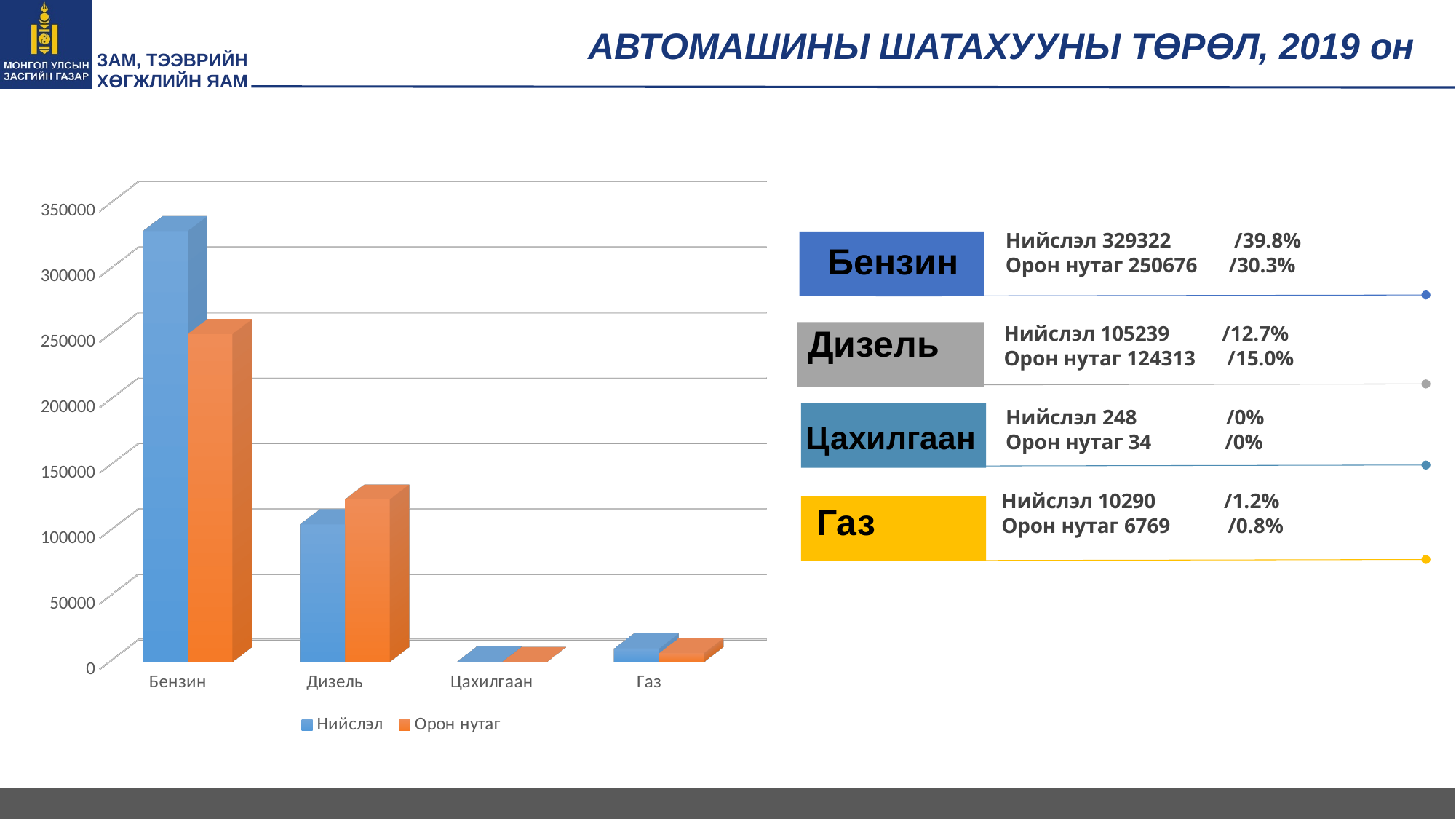
Which series is shown in orange in the chart? Орон нутаг What is the difference between the Нийслэл and Орон нутаг values for Бензин? 78646 What is the Нийслэл value for Газ? 10290 Which category has the highest Нийслэл value? Бензин Is the Орон нутаг value for Бензин greater or less than 200000? greater Which category has the lowest Орон нутаг value? Цахилгаан What kind of chart is shown on the slide? bar chart How many series does the chart legend list? 2 What is the Нийслэл value for Бензин? 329322 For Дизель, which is larger: the Нийслэл value or the Орон нутаг value? Орон нутаг What is the Орон нутаг value for Дизель? 124313 How many fuel-type categories are shown on the x axis of the chart? 4